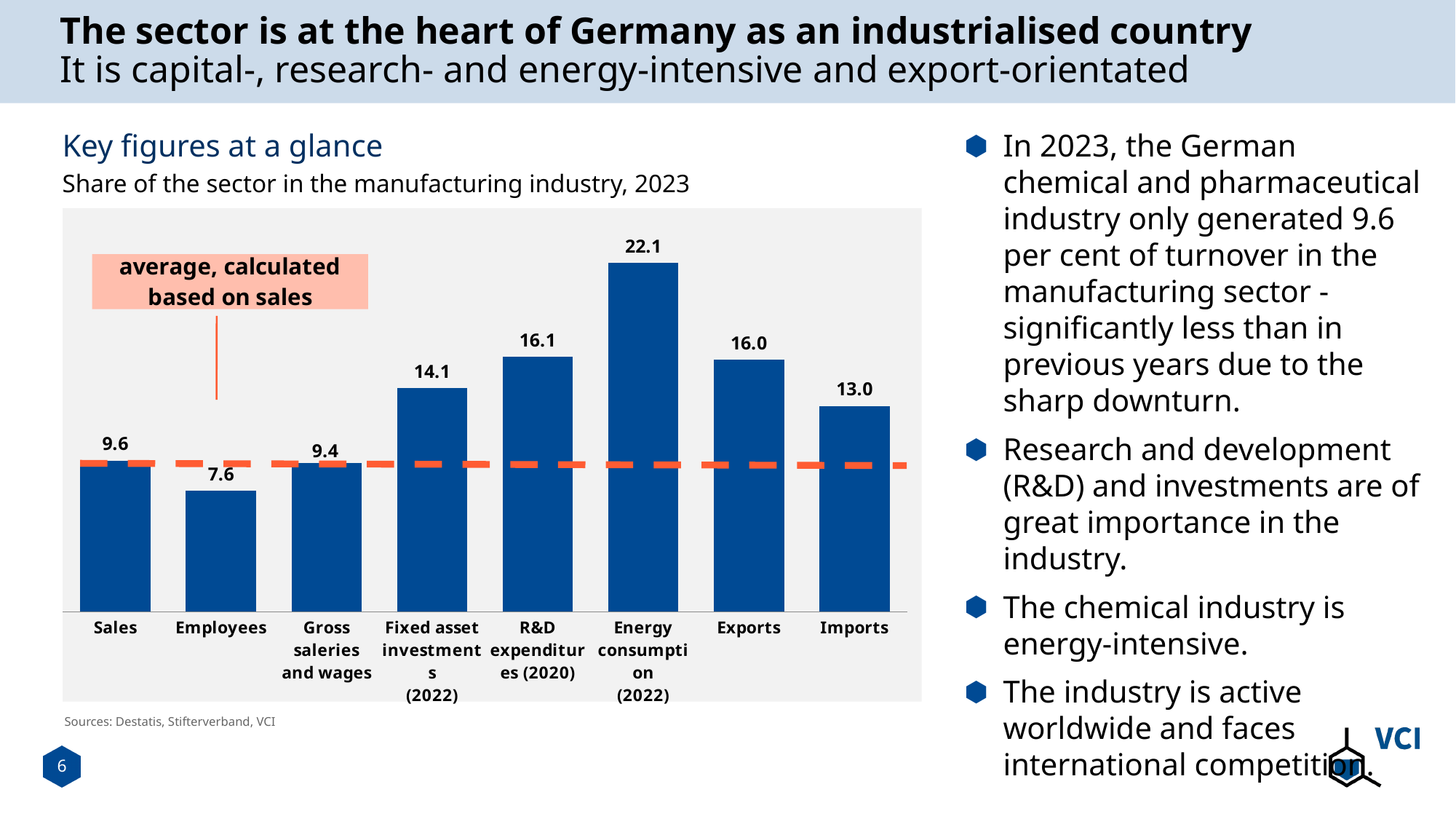
What is the difference between the values for R&D expenditures (2020) and Exports? 0.1 Which is larger, the value for Gross salaries and wages or the value for Imports? Imports What is the value for Imports? 13.0 How many categories are shown in the bar chart? 8 What does the dashed orange line in the chart represent? average, calculated based on sales What is the value for Sales in the 'Key figures at a glance' chart? 9.6 Which category has the highest value? Energy consumption (2022) What is the value for Employees? 7.6 What kind of chart is shown on the slide? bar chart Which category has the lowest value? Employees What is the value for Energy consumption (2022)? 22.1 What is the difference between the values for Fixed asset investments (2022) and Employees? 6.5